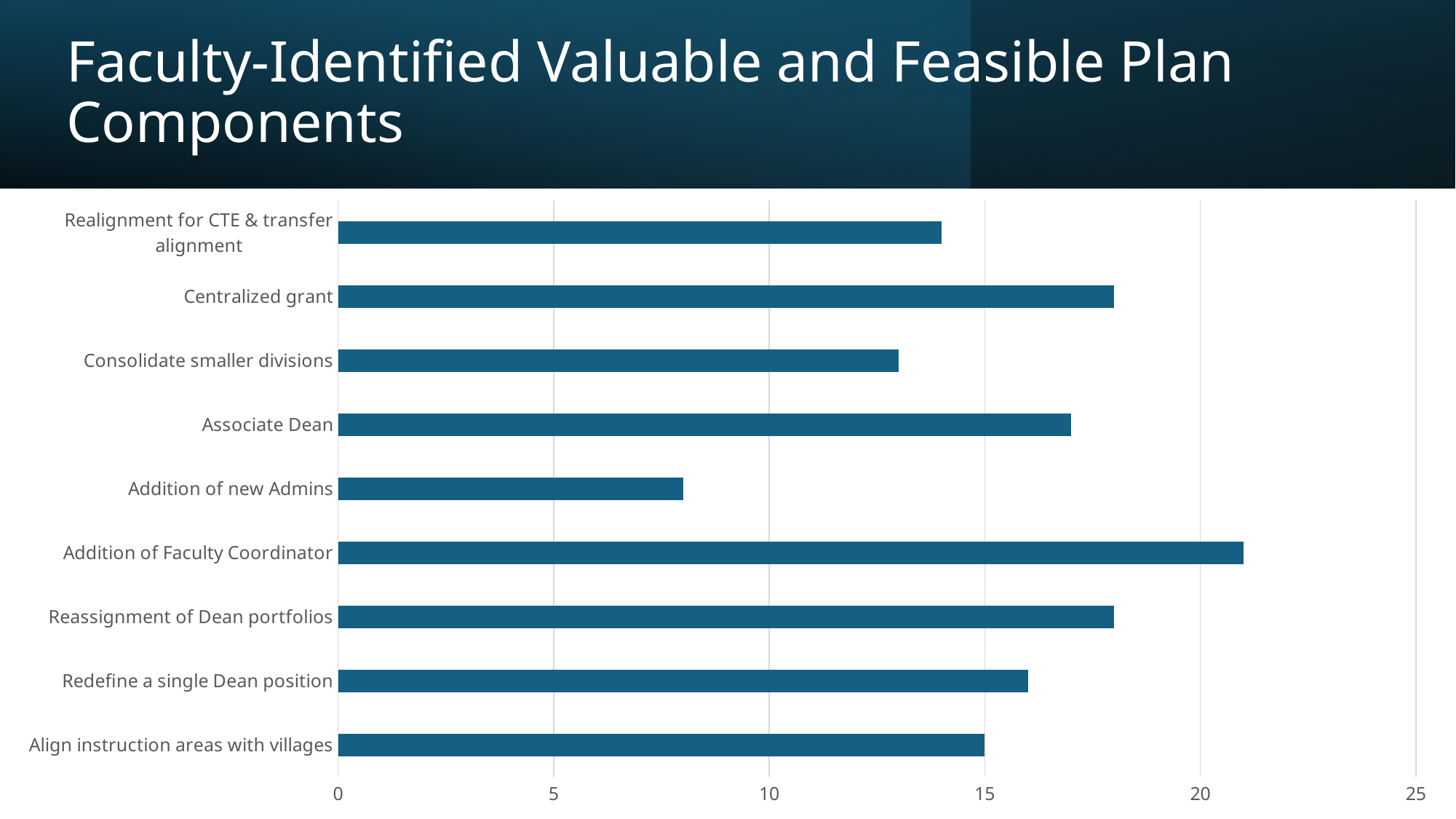
Is the value for Realignment for CTE & transfer alignment greater or less than 10? greater Which plan component has the lowest value? Addition of new Admins Is the value for Centralized grant greater or less than 15? greater How many plan components (categories) are shown in the chart? 9 Which has a larger value, Redefine a single Dean position or Realignment for CTE & transfer alignment? Redefine a single Dean position Is the value for Consolidate smaller divisions greater or less than 15? less Which has a larger value, Associate Dean or Consolidate smaller divisions? Associate Dean What is the title of the slide containing the chart? Faculty-Identified Valuable and Feasible Plan Components Which plan component has the highest value? Addition of Faculty Coordinator What kind of chart is shown on the slide? bar chart